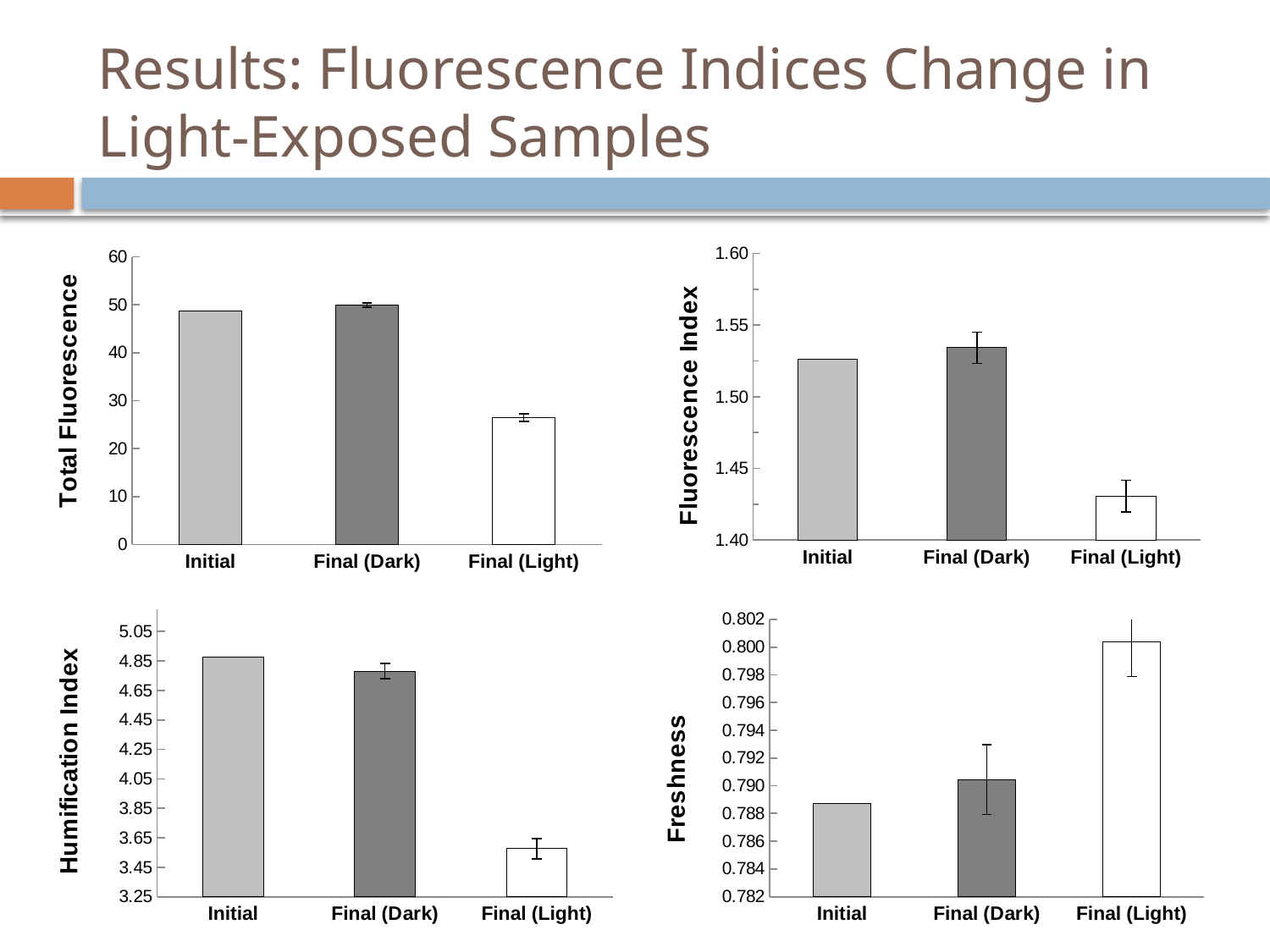
In the Total Fluorescence chart, is the value for Final (Light) greater or less than 30? less In the Total Fluorescence chart, which category has the lowest value? Final (Light) How many categories are shown on the x axis of the Freshness chart at the bottom right? 3 In the Total Fluorescence chart, is the value for Initial greater or less than 40? greater In the Freshness chart, which is larger, the value for Initial or the value for Final (Light)? Final (Light) In the Fluorescence Index chart, is the value for Final (Light) greater or less than 1.45? less In the Freshness chart, which category has the highest value? Final (Light) What kind of chart is the Total Fluorescence chart at the top left of the slide? bar chart In the Humification Index chart, which category has the highest value? Initial In the Fluorescence Index chart, which category has the lowest value? Final (Light)